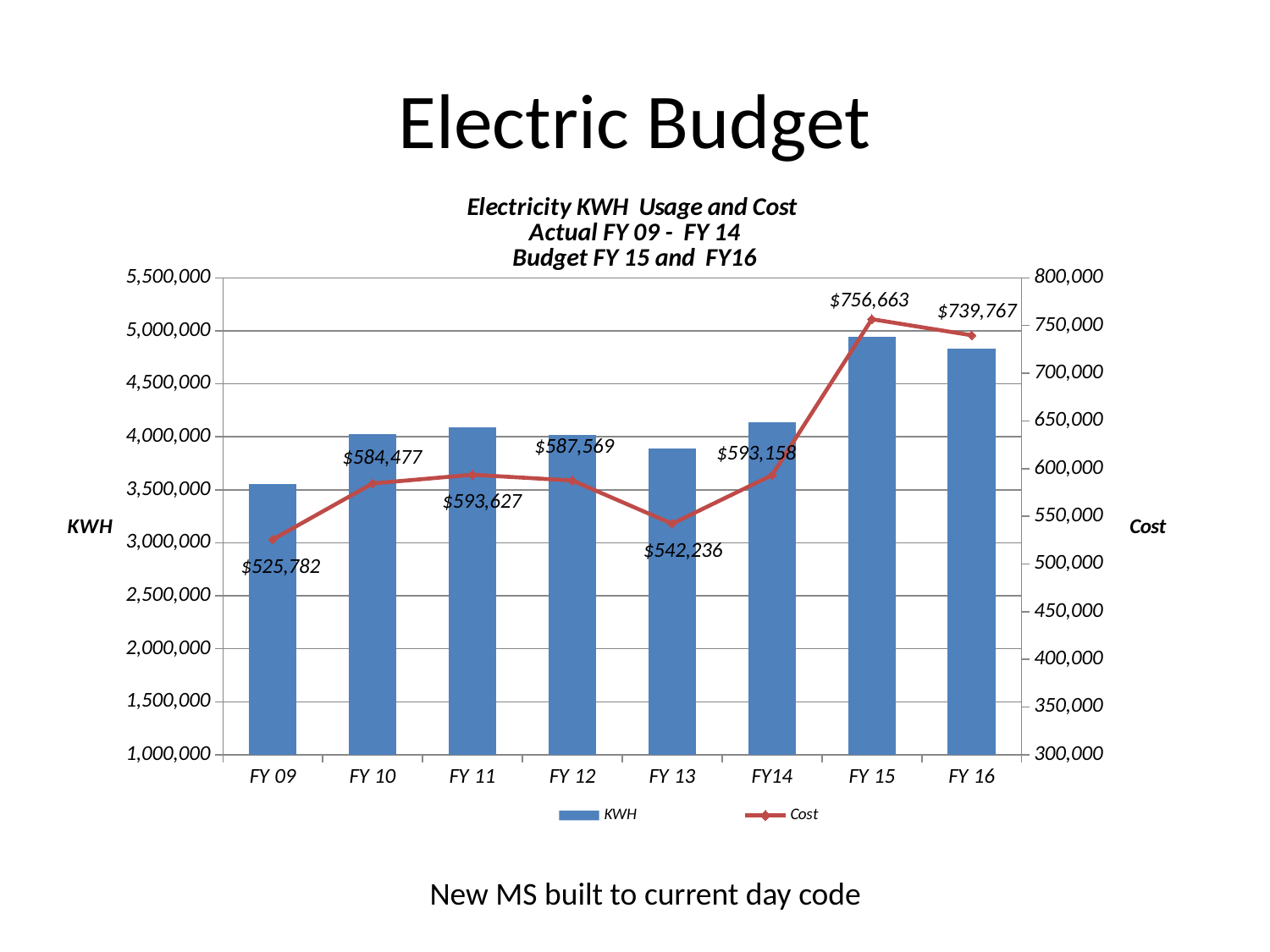
What is the Cost value for FY 13? $542,236 What is the Cost value for FY 15? $756,663 What is the difference between the Cost for FY 15 and the Cost for FY 16? $16,896 Which is larger, the Cost for FY 10 or the Cost for FY 13? FY 10 How many fiscal years are shown on the x axis? 8 Which fiscal year has the highest Cost? FY 15 Is the KWH value for FY 15 greater or less than 4,500,000? greater What is the Cost value for FY 16? $739,767 How many series does the legend list? 2 What is the Cost value for FY 09? $525,782 Is the KWH value for FY 09 greater or less than 4,000,000? less Which fiscal year has the lowest Cost? FY 09